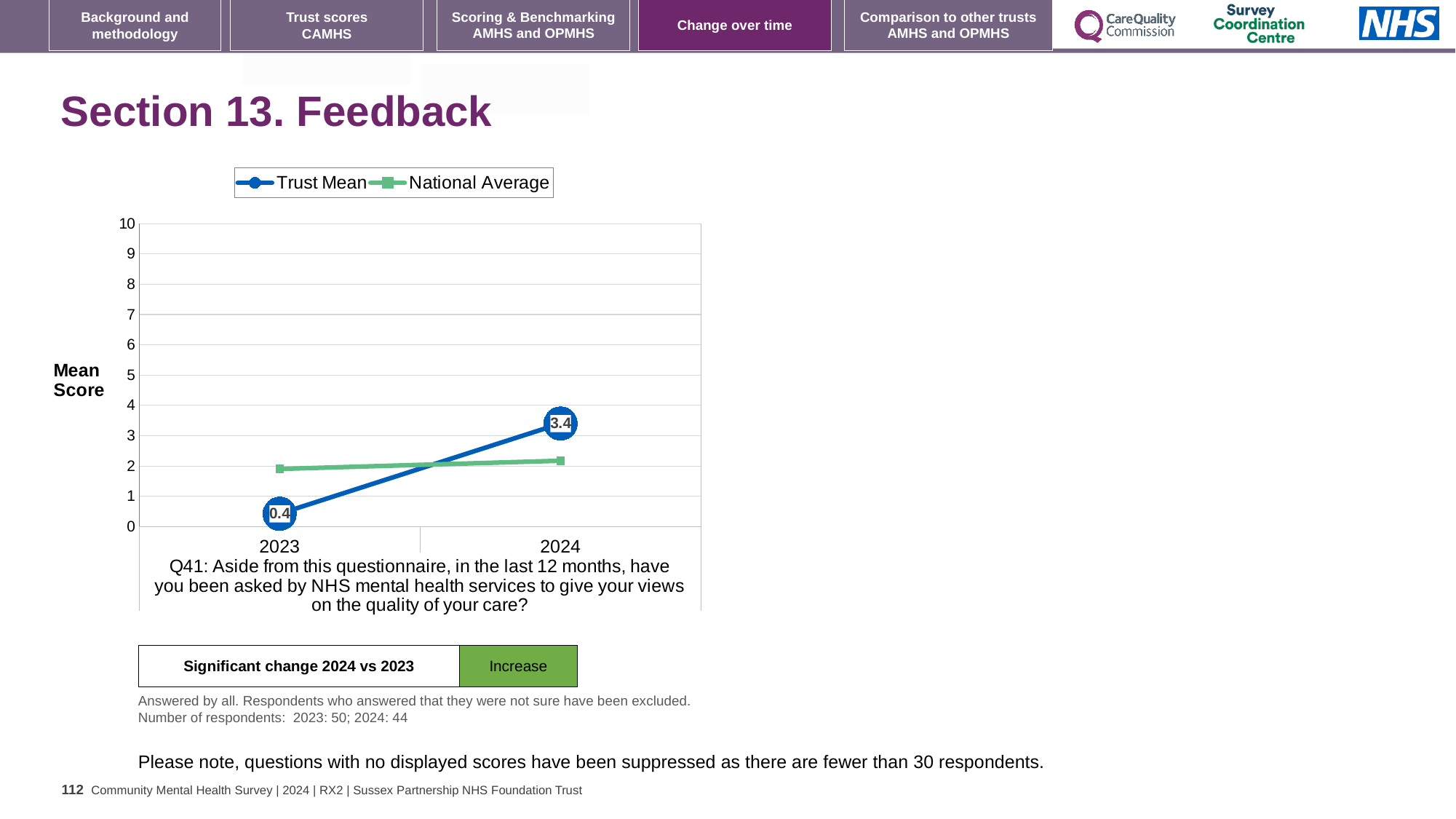
What is the Trust Mean value for 2024? 3.4 Does the Trust Mean rise or fall from 2023 to 2024? rise How many years are shown on the x axis of the chart? 2 What type of chart is shown on the slide? line chart How many series does the chart legend list? 2 By how much did the Trust Mean change from 2023 to 2024? 3.0 In 2023, which is lower, the Trust Mean or the National Average? Trust Mean Which year has the higher Trust Mean, 2023 or 2024? 2024 What is the Trust Mean value for 2023? 0.4 Is the National Average value for 2023 greater or less than 3? less In 2024, which is higher, the Trust Mean or the National Average? Trust Mean